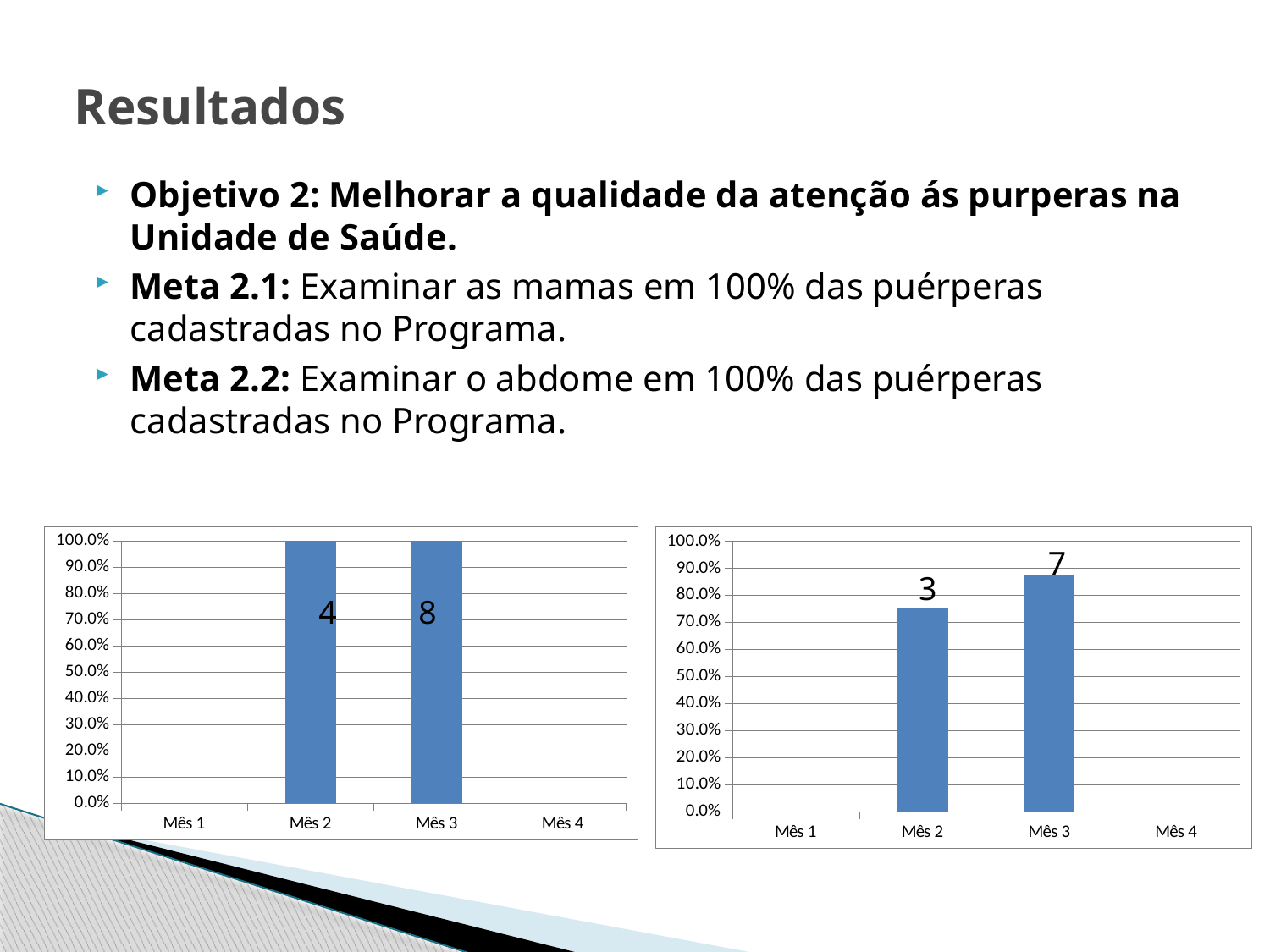
In the chart on the right, what data label is printed on the bar for Mês 2? 3 In the chart on the right, is the value for Mês 3 greater or less than 80.0%? greater In the chart on the right, what data label is printed on the bar for Mês 3? 7 What kind of chart is the chart on the left of the slide? bar chart In the chart on the left, what data label is printed on the bar for Mês 2? 4 In the chart on the right, which is larger, the bar for Mês 2 or the bar for Mês 3? Mês 3 How many categories are shown on the x axis of the chart on the left? 4 In the chart on the right, does the value rise or fall from Mês 2 to Mês 3? rise In the chart on the left, what data label is printed on the bar for Mês 3? 8 In the chart on the right, is the value for Mês 2 greater or less than 80.0%? less In the chart on the right, which month has the highest bar? Mês 3 In the chart on the left, what percentage does the bar for Mês 2 reach on the y axis? 100.0%